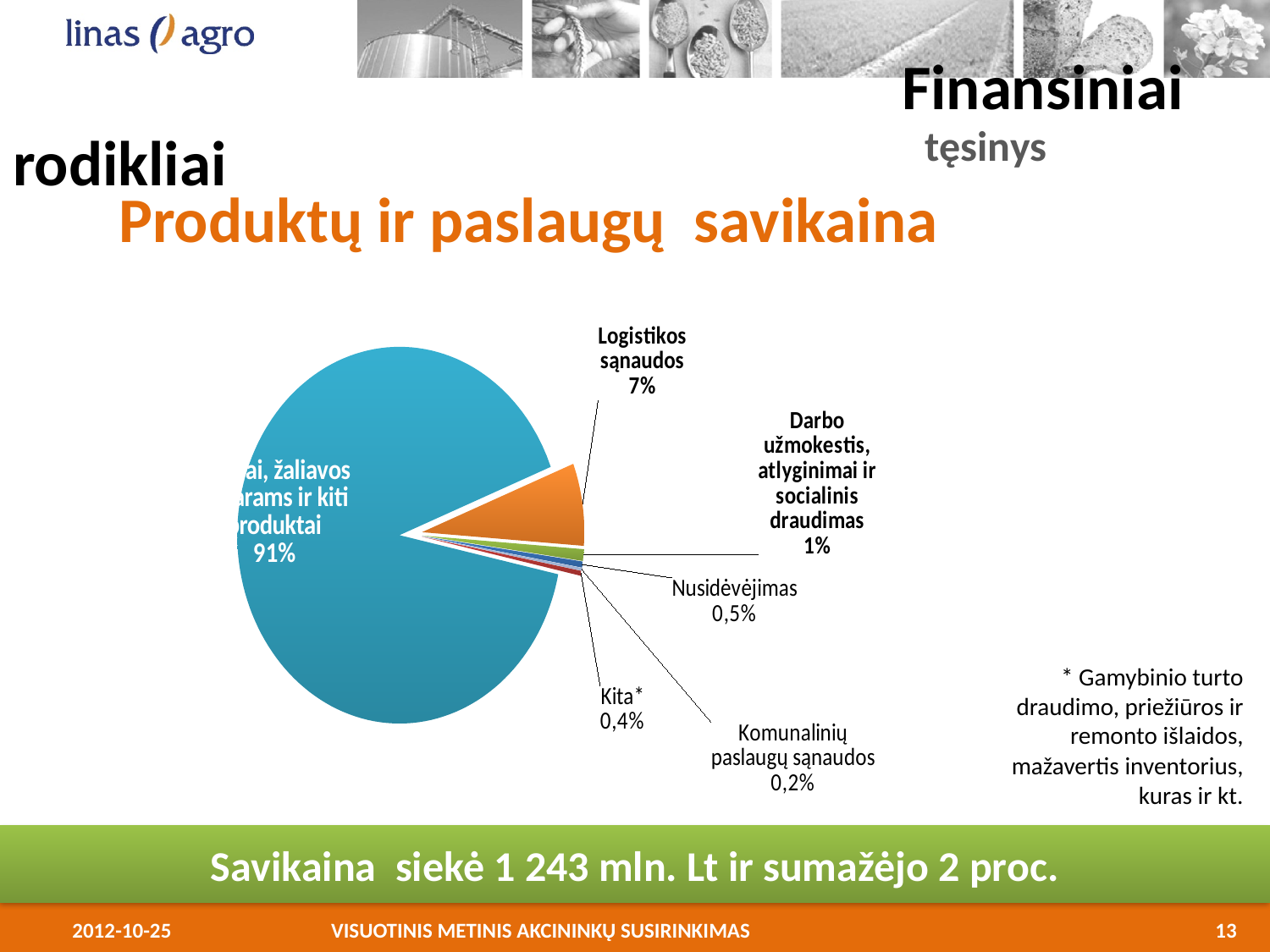
What share does Komunalinių paslaugų sąnaudos represent? 0,2% What share of the cost does Logistikos sąnaudos represent? 7% What share does Darbo užmokestis, atlyginimai ir socialinis draudimas represent? 1% What percentage does the largest slice of the pie represent? 91% What is the title of the chart? Produktų ir paslaugų savikaina What kind of chart is shown on the slide? pie chart How many slices does the pie chart have? 6 What share does Nusidėvėjimas represent? 0,5% What share does Kita* represent? 0,4% Which is larger: Logistikos sąnaudos or Nusidėvėjimas? Logistikos sąnaudos Which category has the smallest share of the pie? Komunalinių paslaugų sąnaudos By how many percentage points does Logistikos sąnaudos exceed Darbo užmokestis, atlyginimai ir socialinis draudimas? 6 percentage points